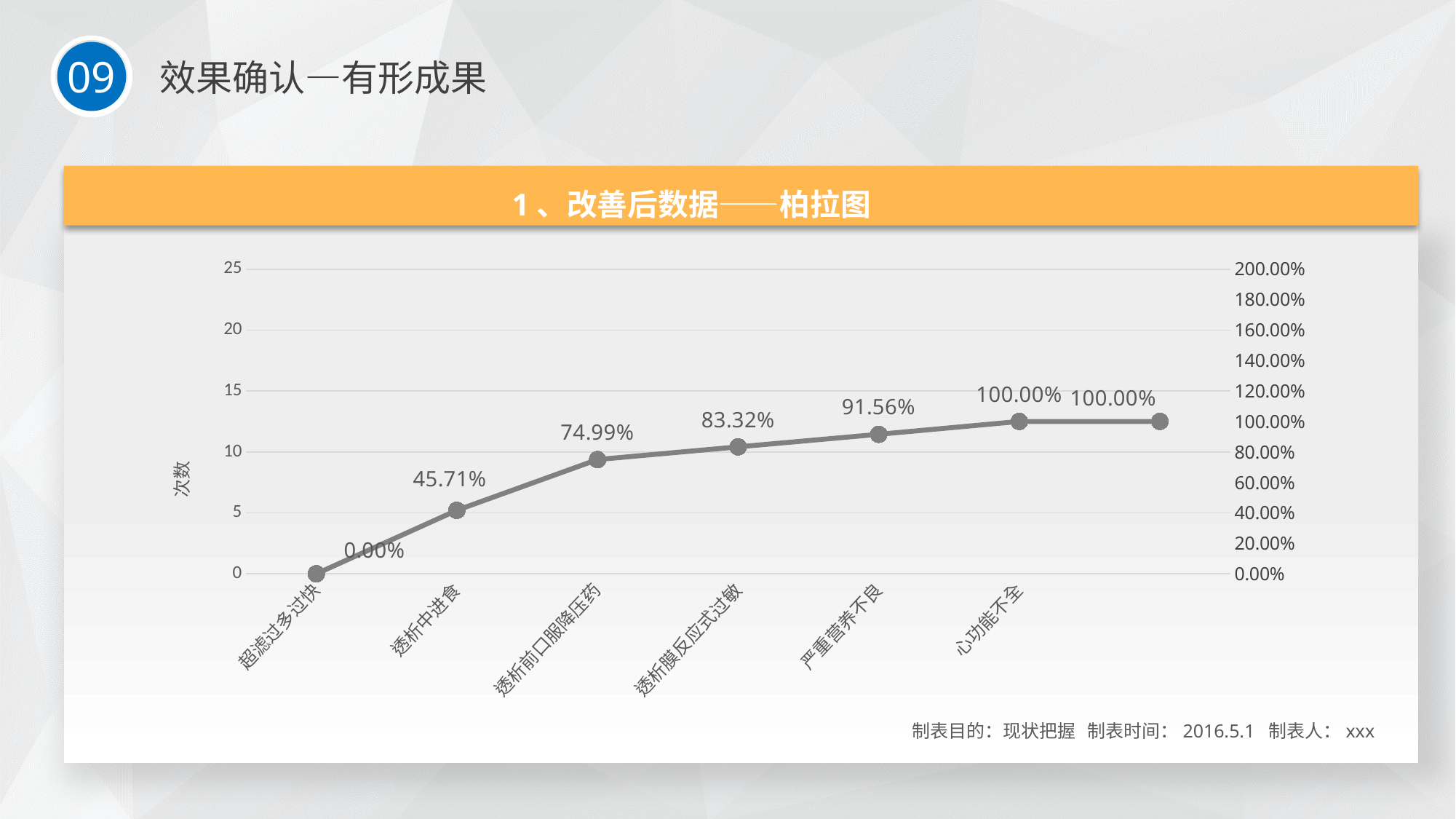
What is the cumulative percentage shown for 严重营养不良? 91.56% What kind of chart is shown on the slide? line chart What is the cumulative percentage shown for 透析前口服降压药? 74.99% What is the cumulative percentage shown for 透析膜反应式过敏? 83.32% What is the cumulative percentage shown for 心功能不全? 100.00% Which has a higher cumulative percentage, 严重营养不良 or 透析膜反应式过敏? 严重营养不良 What is the difference between the cumulative percentages for 透析前口服降压药 and 透析中进食? 29.28% Is the cumulative percentage for 透析中进食 greater or less than 60.00%? less What is the cumulative percentage shown for 透析中进食? 45.71% What is the title of the left vertical axis? 次数 Which category has the lowest cumulative percentage on the line? 超滤过多过快 How many data points are plotted on the line? 7